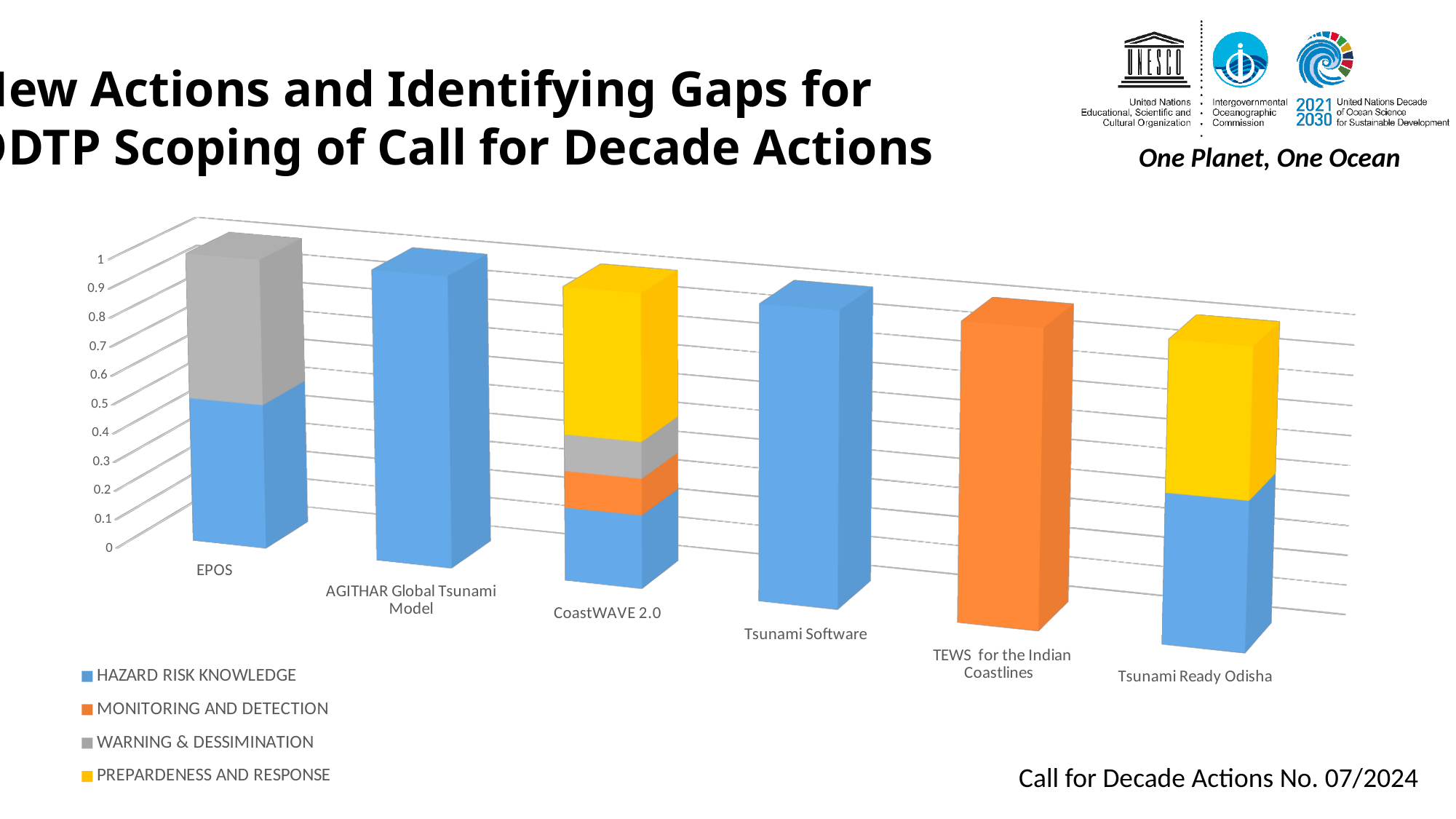
Which series is shown in orange in the chart legend? MONITORING AND DETECTION Is the HAZARD RISK KNOWLEDGE value for EPOS greater or less than 0.8? less Which two series make up the EPOS bar? HAZARD RISK KNOWLEDGE and WARNING & DESSIMINATION Which category's bar consists entirely of the MONITORING AND DETECTION series? TEWS for the Indian Coastlines Which category is the only one whose bar includes all four series? CoastWAVE 2.0 In the Tsunami Ready Odisha bar, which is larger: the PREPAREDENESS AND RESPONSE segment or the HAZARD RISK KNOWLEDGE segment? Neither; they are equal How many categories (projects) are shown along the x axis of the chart? 6 Is the HAZARD RISK KNOWLEDGE value for Tsunami Ready Odisha greater or less than 0.8? less How many series does the chart legend list? 4 What kind of chart is shown on the slide? bar chart In the CoastWAVE 2.0 bar, which is larger: the PREPAREDENESS AND RESPONSE segment or the MONITORING AND DETECTION segment? PREPARDENESS AND RESPONSE Which series is shown in yellow in the chart legend? PREPARDENESS AND RESPONSE